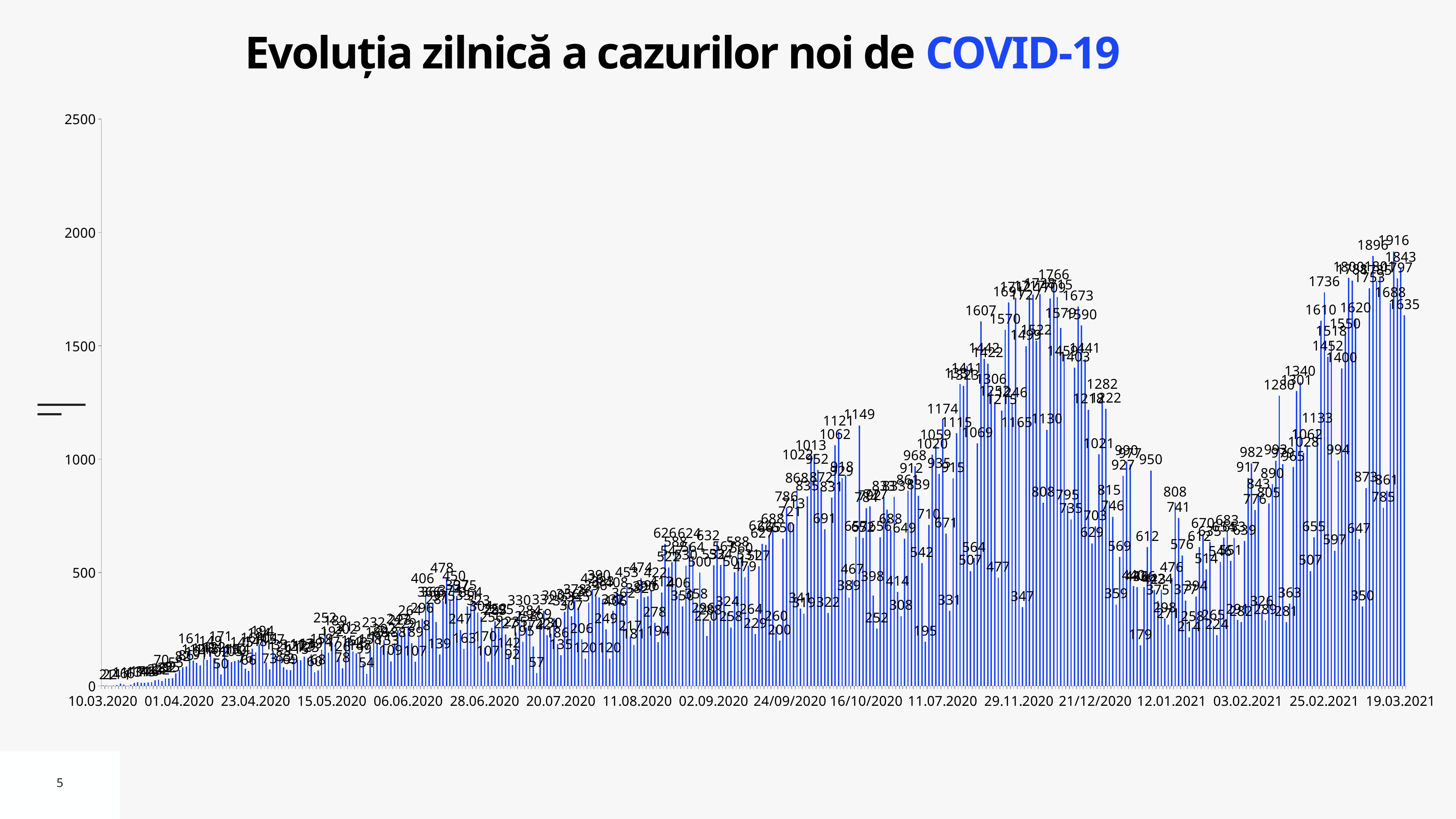
Is the value for 10.03.2020 greater or less than 500? less What is the first date shown on the horizontal axis? 10.03.2020 Is the value of the tallest bar near 29.11.2020 greater or less than 1500? greater What is the last date shown on the horizontal axis? 19.03.2021 What is the highest daily value labelled on the chart? 1916 What is the value of the tallest bar between 06.06.2020 and 28.06.2020? 478 Overall, do the daily values rise or fall from 10.03.2020 to 19.03.2021? rise What is the maximum value shown on the vertical axis? 2500 Which is larger: the peak in late November 2020 (1766) or the peak in March 2021 (1916)? the peak in March 2021 (1916) What kind of chart is shown on the slide? bar chart What is the difference between the March 2021 peak of 1916 and the November 2020 peak of 1766? 150 What is the title of the chart? Evoluția zilnică a cazurilor noi de COVID-19